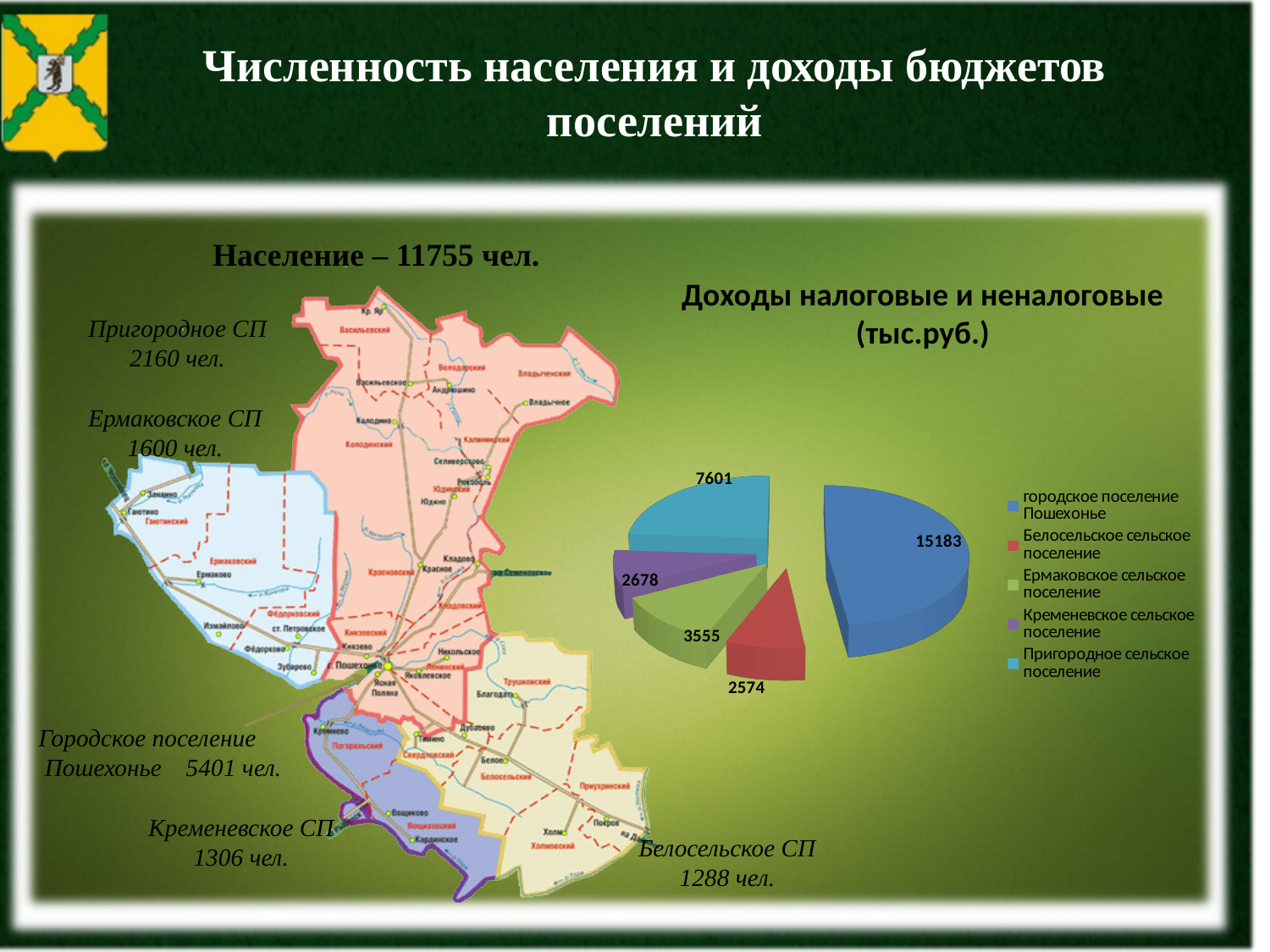
What type of chart is shown on the slide? pie chart What is the difference between the values for городское поселение Пошехонье and Пригородное сельское поселение? 7582 What is the value for городское поселение Пошехонье in the pie chart? 15183 What is the value for Ермаковское сельское поселение in the pie chart? 3555 How many slices does the pie chart have? 5 Which settlement has the smallest slice in the pie chart? Белосельское сельское поселение Which settlement has the largest slice in the pie chart? городское поселение Пошехонье Which is larger: the value for Кременевское сельское поселение or Белосельское сельское поселение? Кременевское сельское поселение What is the value for Белосельское сельское поселение in the pie chart? 2574 What is the title of the chart? Доходы налоговые и неналоговые (тыс.руб.) What is the value for Пригородное сельское поселение in the pie chart? 7601 What colour is the slice for Ермаковское сельское поселение? green